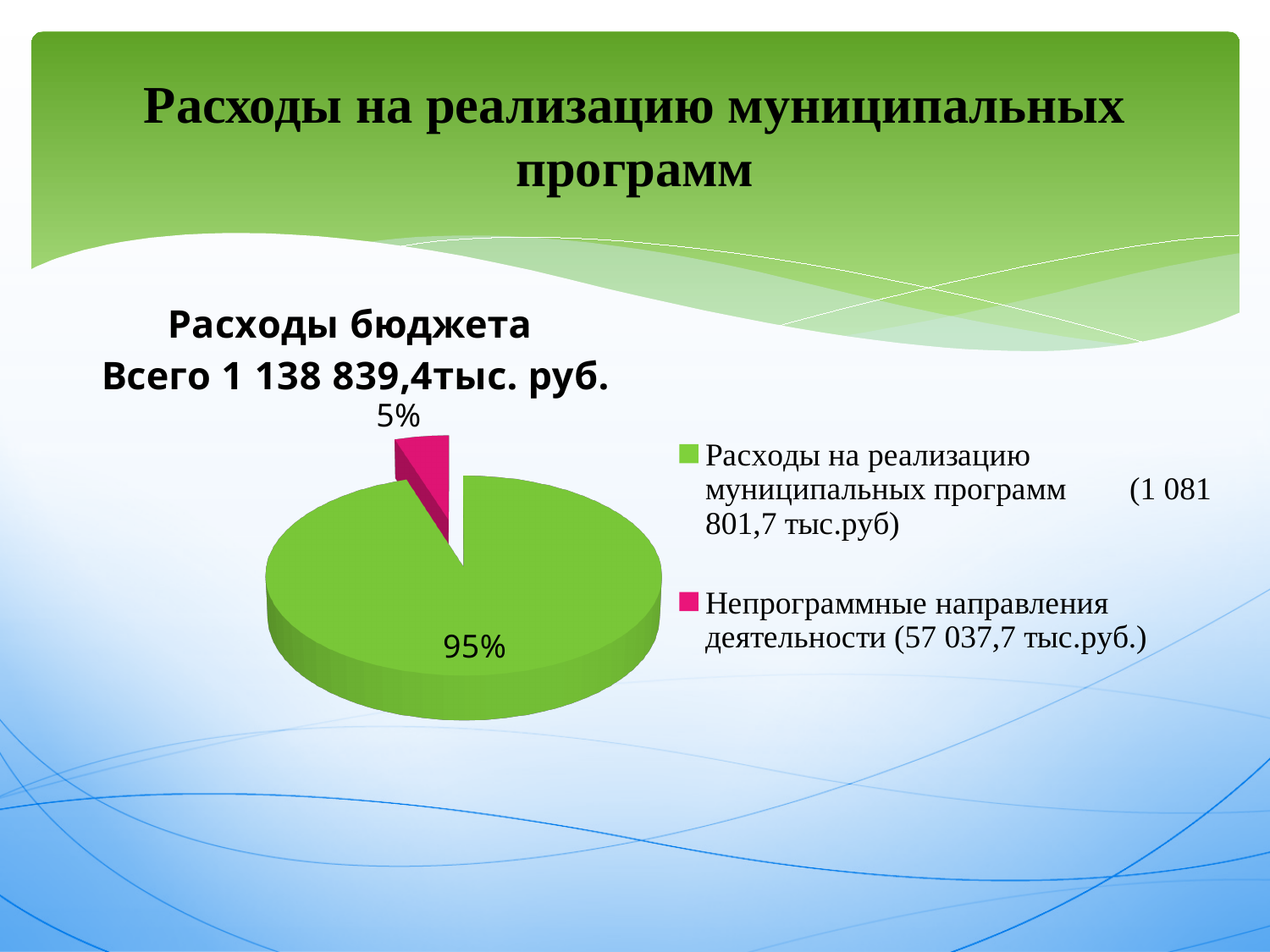
What amount in thousand rubles does the legend give for "Непрограммные направления деятельности"? 57 037,7 тыс.руб. What is the difference in percentage points between the two slices of the pie? 90 What share of the pie does "Расходы на реализацию муниципальных программ" take? 95% What kind of chart is shown on the slide? pie chart Which slice of the pie is the largest? Расходы на реализацию муниципальных программ What amount in thousand rubles does the legend give for "Расходы на реализацию муниципальных программ"? 1 081 801,7 тыс.руб What colour is the slice for "Непрограммные направления деятельности"? pink Which is larger: the share for "Расходы на реализацию муниципальных программ" or the share for "Непрограммные направления деятельности"? Расходы на реализацию муниципальных программ Which slice of the pie is the smallest? Непрограммные направления деятельности How many slices does the pie chart have? 2 How many entries does the legend list? 2 What share of the pie does "Непрограммные направления деятельности" take? 5%